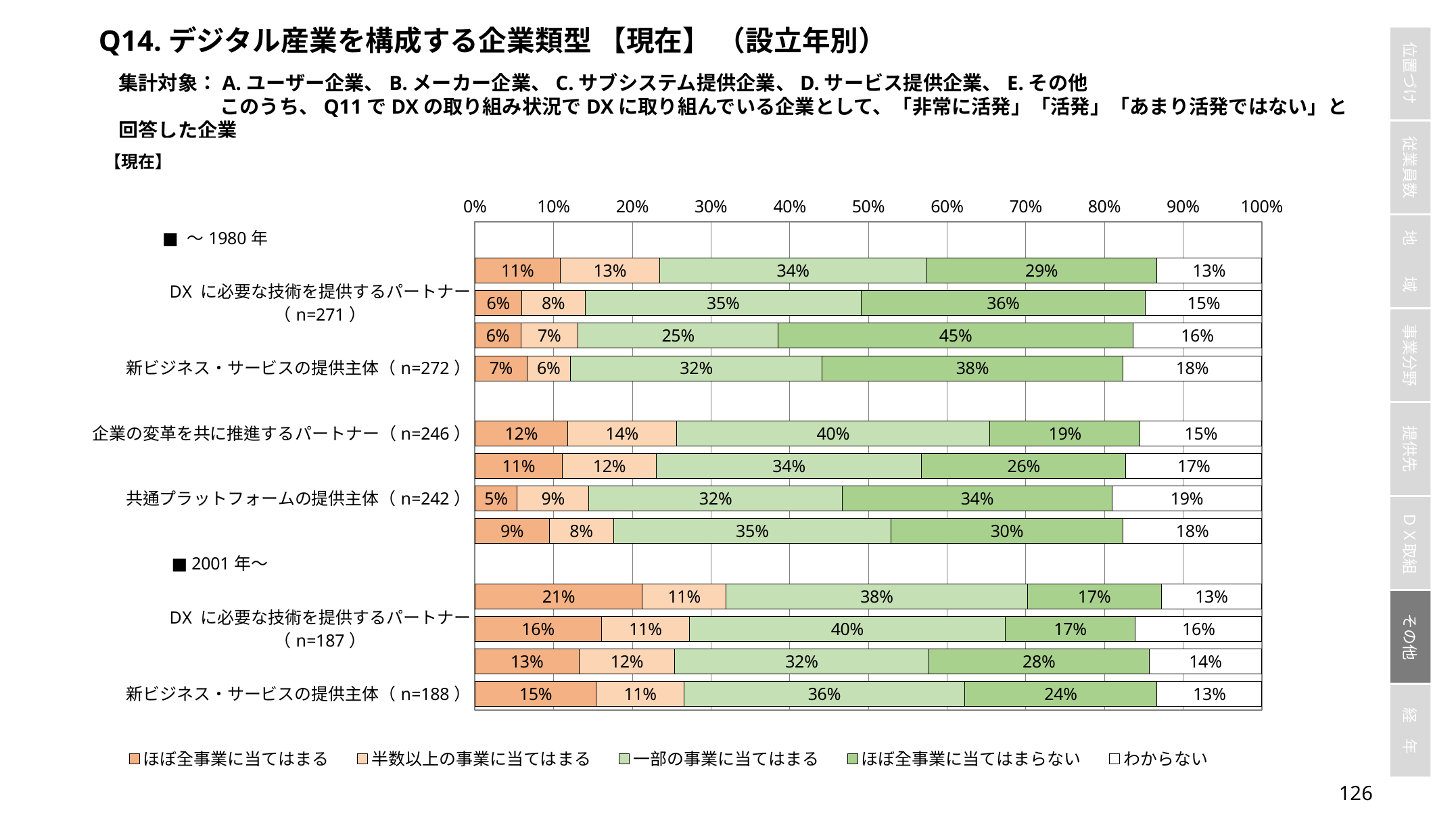
What is the first entry in the legend? ほぼ全事業に当てはまる What is the difference in ほぼ全事業に当てはまらない between 新ビジネス・サービスの提供主体 (n=272) and 新ビジネス・サービスの提供主体 (n=188)? 14 percentage points What is the maximum value shown on the horizontal axis? 100% What is the value of ほぼ全事業に当てはまらない for 新ビジネス・サービスの提供主体 (n=188)? 24% In the topmost bar of the chart (under ～1980年), what is the value of 一部の事業に当てはまる? 34% What is the value of 一部の事業に当てはまる for 企業の変革を共に推進するパートナー (n=246)? 40% How many series does the legend list? 5 What is the value of わからない for 共通プラットフォームの提供主体 (n=242)? 19% What kind of chart is shown on the slide? Stacked bar chart Which segment is the largest in the bar for 企業の変革を共に推進するパートナー (n=246)? 一部の事業に当てはまる Which has the larger 一部の事業に当てはまる share: 企業の変革を共に推進するパートナー (n=246) or 共通プラットフォームの提供主体 (n=242)? 企業の変革を共に推進するパートナー (n=246) What is the value of ほぼ全事業に当てはまる for 新ビジネス・サービスの提供主体 (n=272)? 7%